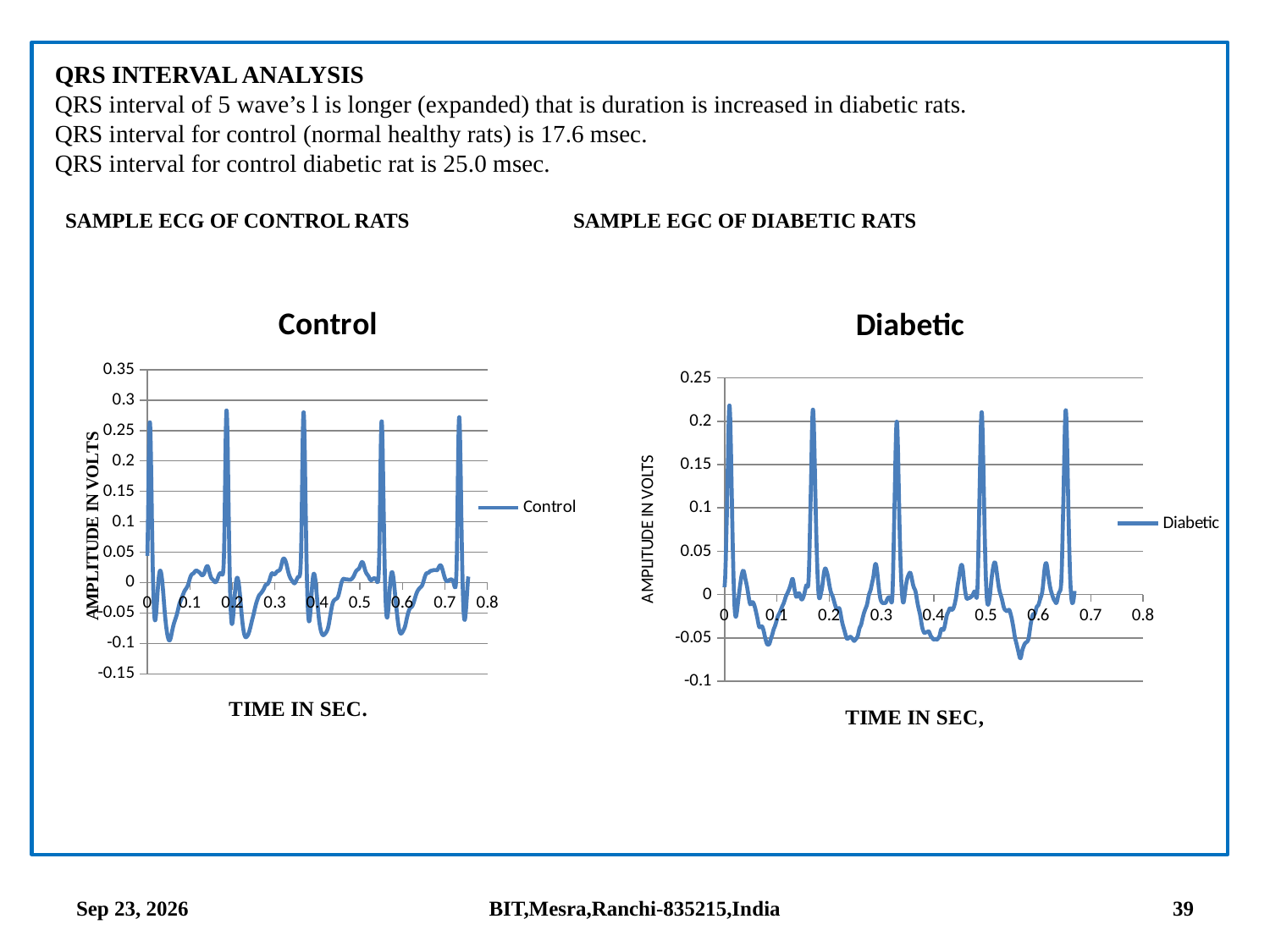
What type of chart is the Control chart on the left? line chart In the Control chart, is the value of the highest peak greater or less than 0.2? greater In the Diabetic chart, how many large spikes (peaks) does the line show? 5 In the Control chart, what is the label of the x axis? TIME IN SEC. What type of chart is the Diabetic chart on the right? line chart In the Control chart, how many series does the legend list? 1 In the Diabetic chart, what is the name of the series shown in the legend? Diabetic In the Diabetic chart, is the lowest value of the line greater or less than 0? less In the Control chart, how many large spikes (peaks) does the line show? 5 In the Control chart, is the value of the first peak near time 0 greater or less than 0.3? less